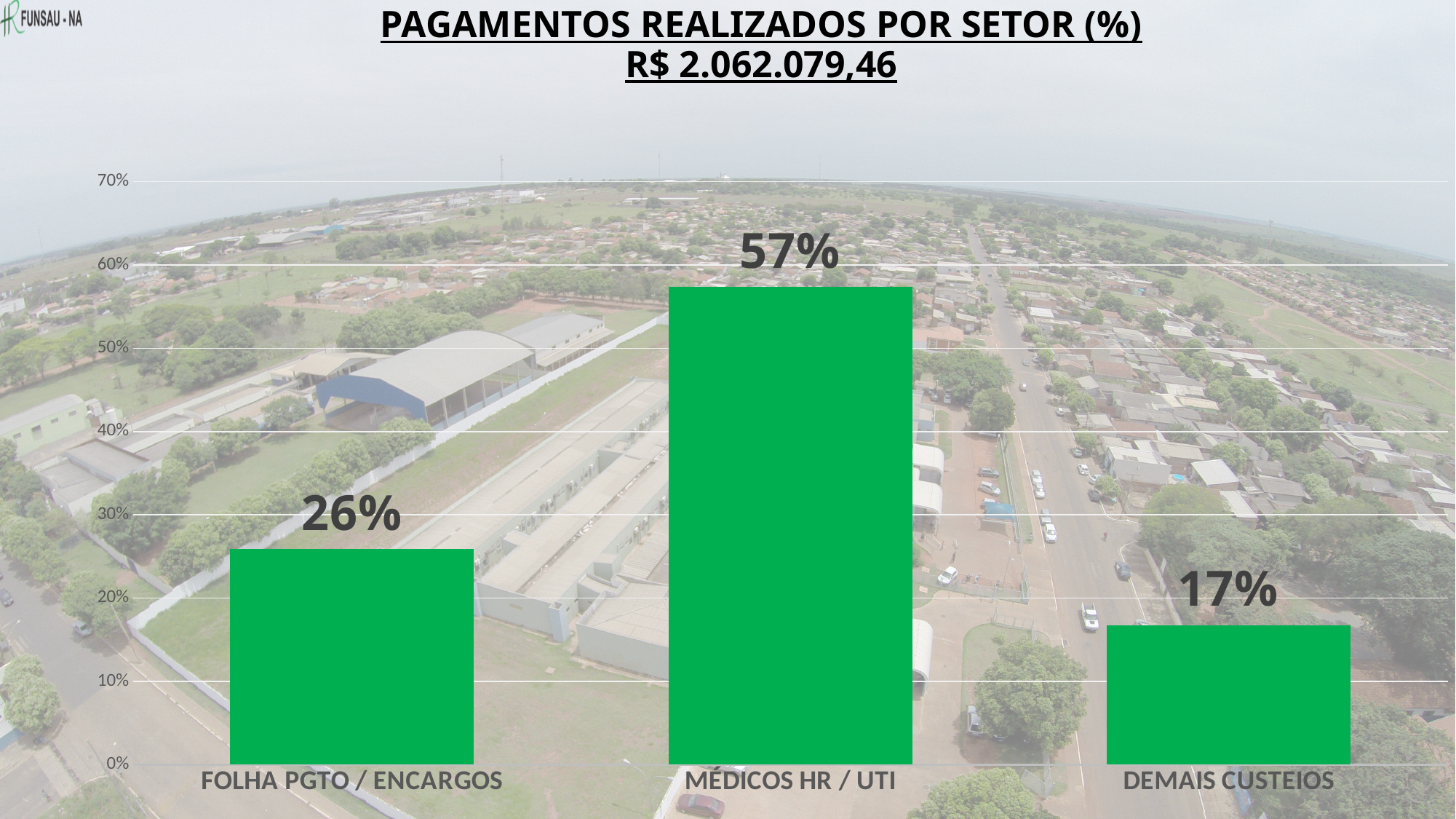
What total amount is shown in the chart title? R$ 2.062.079,46 How many categories are shown in the chart? 3 Which category has the highest value? MÉDICOS HR / UTI What is the value for FOLHA PGTO / ENCARGOS? 26% What is the value for MÉDICOS HR / UTI? 57% Which category has the lowest value? DEMAIS CUSTEIOS What is the difference between the values for FOLHA PGTO / ENCARGOS and DEMAIS CUSTEIOS? 9% What is the difference between the values for MÉDICOS HR / UTI and FOLHA PGTO / ENCARGOS? 31% Which is larger, the value for FOLHA PGTO / ENCARGOS or the value for DEMAIS CUSTEIOS? FOLHA PGTO / ENCARGOS Is the value for MÉDICOS HR / UTI greater or less than 50%? greater What is the value for DEMAIS CUSTEIOS? 17% What kind of chart is shown on the slide? bar chart